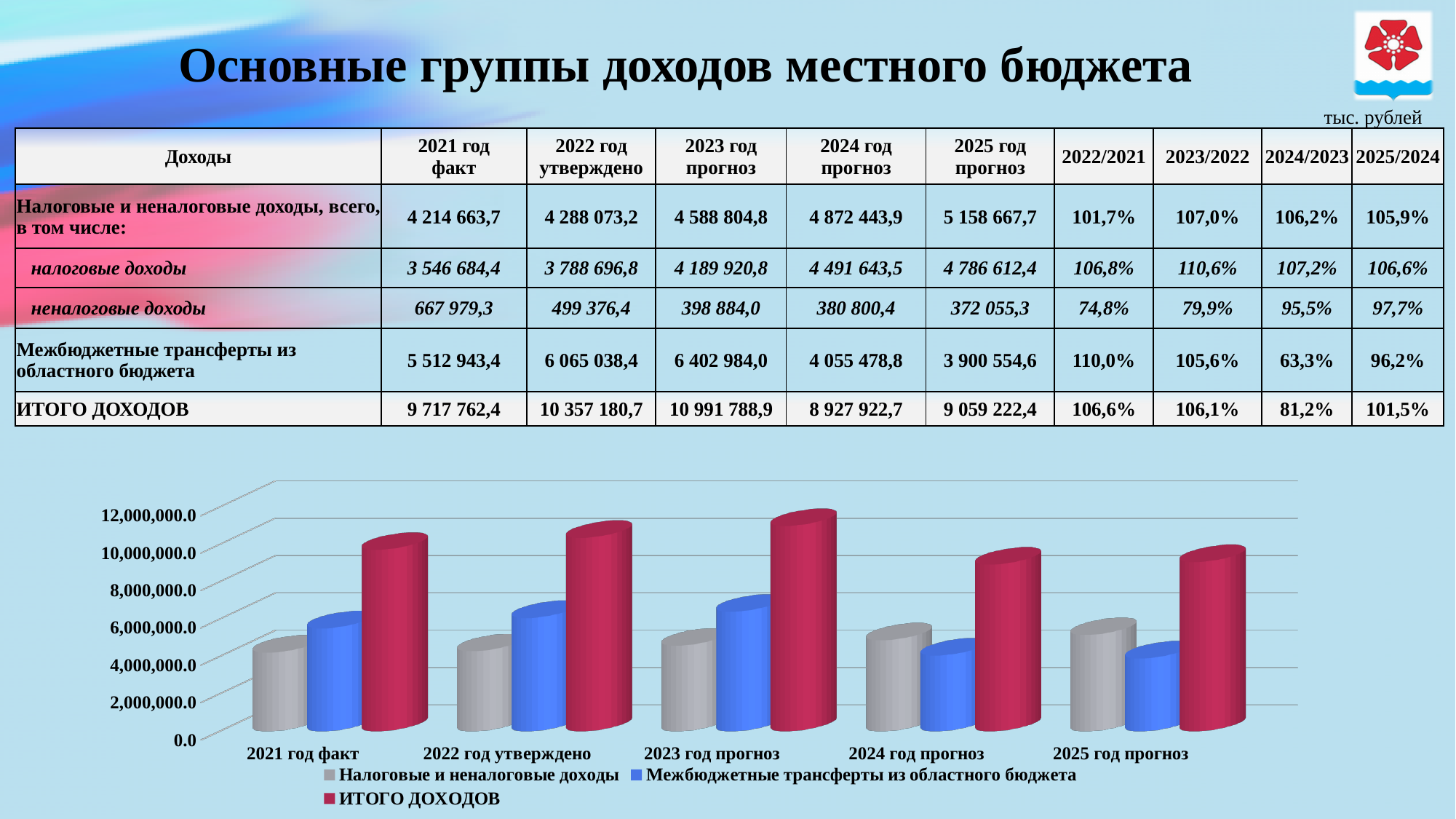
Is the value of ИТОГО ДОХОДОВ for 2023 год прогноз greater or less than 10,000,000.0? greater Is the value of Налоговые и неналоговые доходы for 2021 год факт greater or less than 6,000,000.0? less How many series does the chart legend list? 3 What colour are the ИТОГО ДОХОДОВ bars in the chart? red In which year category is the Межбюджетные трансферты из областного бюджета bar the tallest? 2023 год прогноз What is the value of ИТОГО ДОХОДОВ for 2021 год факт, as printed in the table? 9 717 762,4 Do the Налоговые и неналоговые доходы bars rise or fall from 2021 год факт to 2025 год прогноз? rise For 2024 год прогноз, which is larger: Налоговые и неналоговые доходы or Межбюджетные трансферты из областного бюджета? Налоговые и неналоговые доходы How many year categories are shown along the x axis of the chart? 5 In which year category is the ИТОГО ДОХОДОВ bar the tallest? 2023 год прогноз Using the table values, what is the difference between ИТОГО ДОХОДОВ for 2022 год утверждено and 2021 год факт? 639 418,3 What kind of chart is shown at the bottom of the slide? bar chart